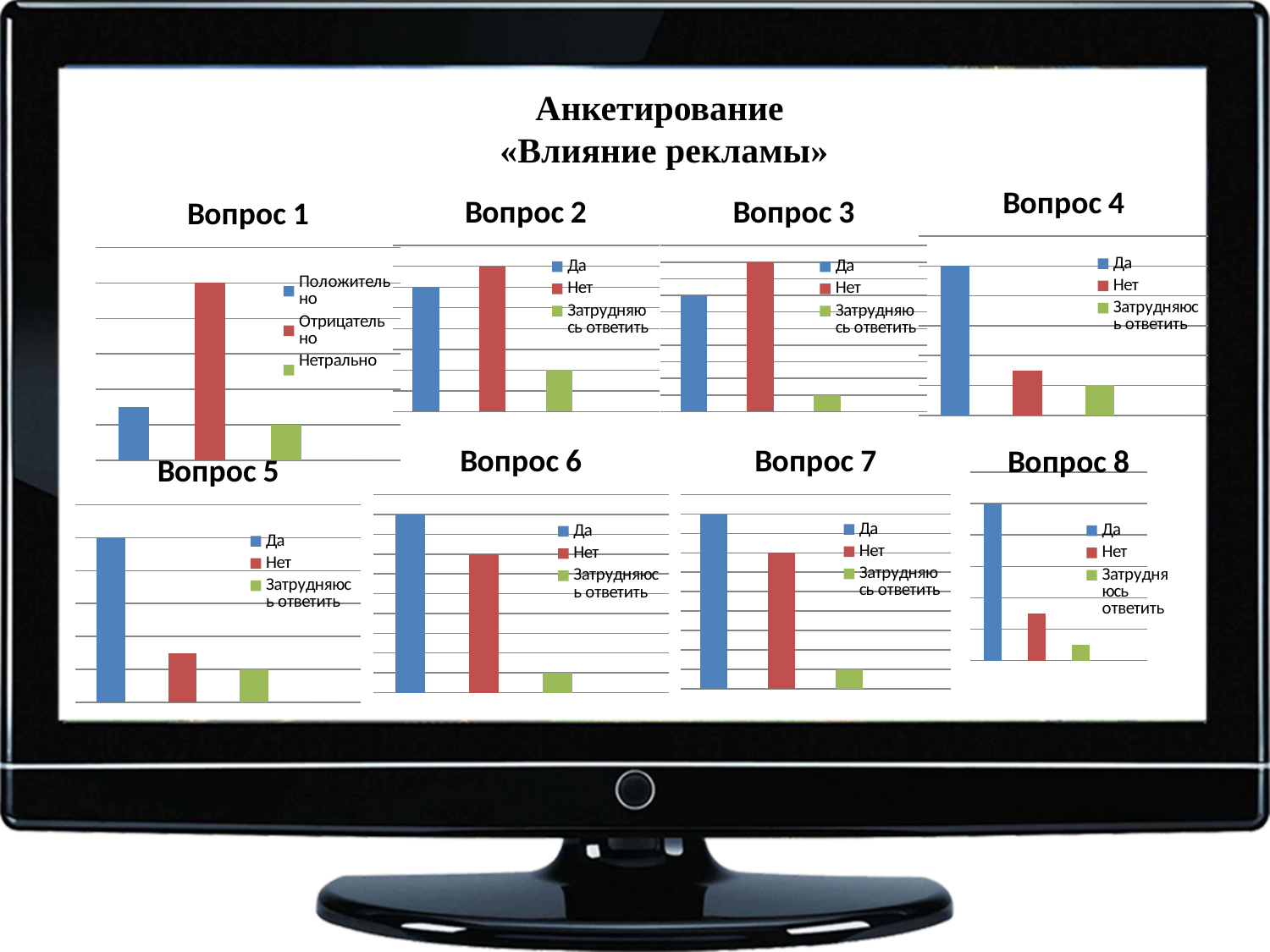
In the chart titled "Вопрос 1", which category has the highest bar? Отрицательно In the chart titled "Вопрос 3", which category has the lowest bar? Затрудняюсь ответить In the chart titled "Вопрос 7", which category has the highest bar? Да In the chart titled "Вопрос 6", which category has the lowest bar? Затрудняюсь ответить In the chart titled "Вопрос 2", which category has the highest bar? Нет In the chart titled "Вопрос 8", which is larger: the bar for Да or the bar for Нет? Да In the chart titled "Вопрос 1", which category has the lowest bar? Нетрально In the chart titled "Вопрос 5", which is larger: the bar for Нет or the bar for Затрудняюсь ответить? Нет What kind of chart is the chart titled "Вопрос 5"? Bar chart How many entries does the legend of the chart titled "Вопрос 2" list? 3 In the chart titled "Вопрос 3", which is larger: the bar for Да or the bar for Нет? Нет